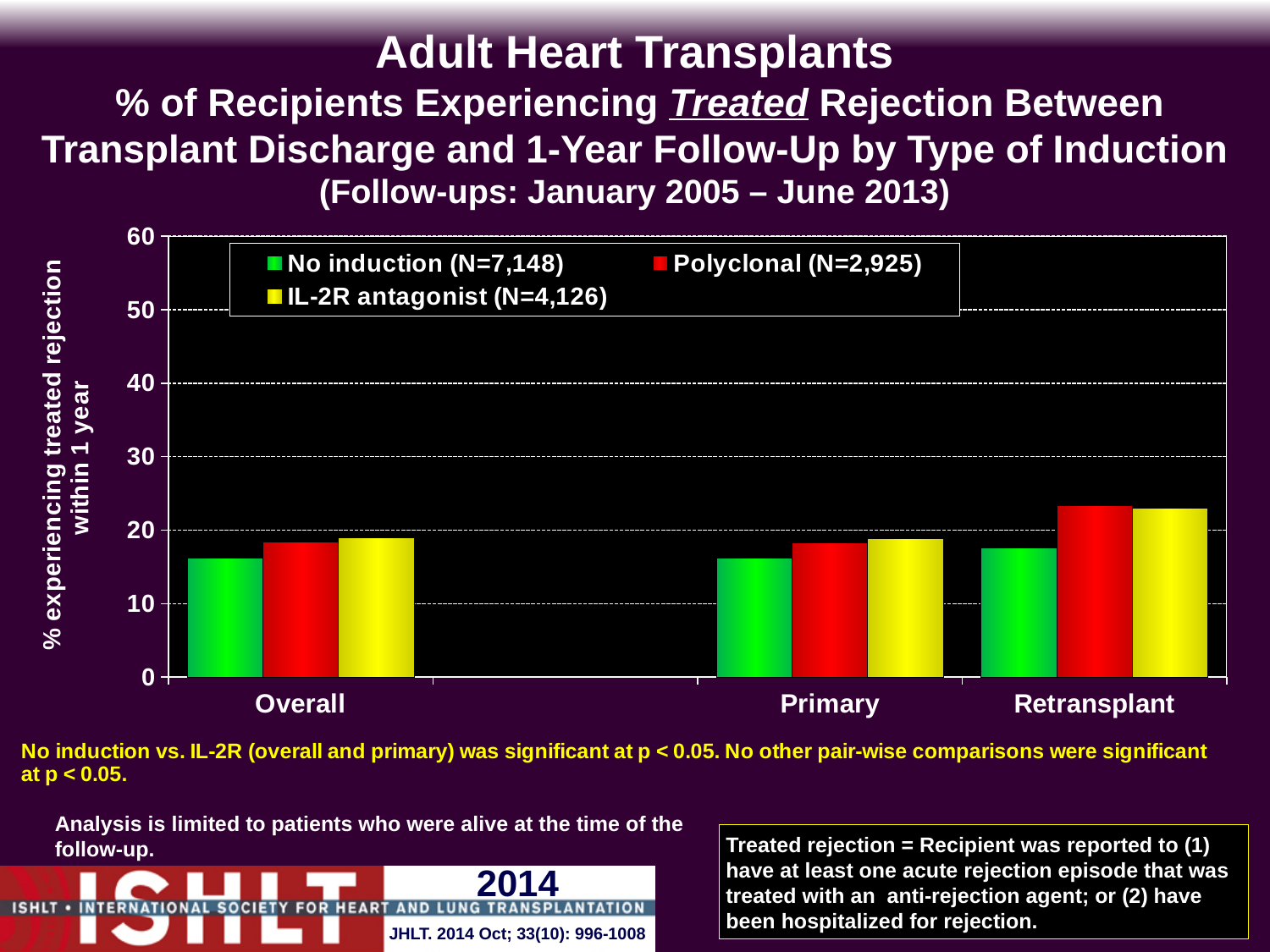
In the Overall category, which is larger: the value for No induction or the value for Polyclonal? Polyclonal In the Retransplant category, which is larger: the value for No induction or the value for Polyclonal? Polyclonal In the Retransplant category, which induction type has the lowest value? No induction Is the value for Polyclonal in the Retransplant category greater or less than 20? greater Is the value for No induction in the Primary category greater or less than 20? less Is the value for No induction in the Overall category greater or less than 20? less What kind of chart is shown on the slide? bar chart According to the legend, what is the N for the No induction group? N=7,148 How many series does the chart's legend list? 3 How many categories are shown on the x axis of the chart? 3 Across the three categories, in which category is the Polyclonal value highest? Retransplant